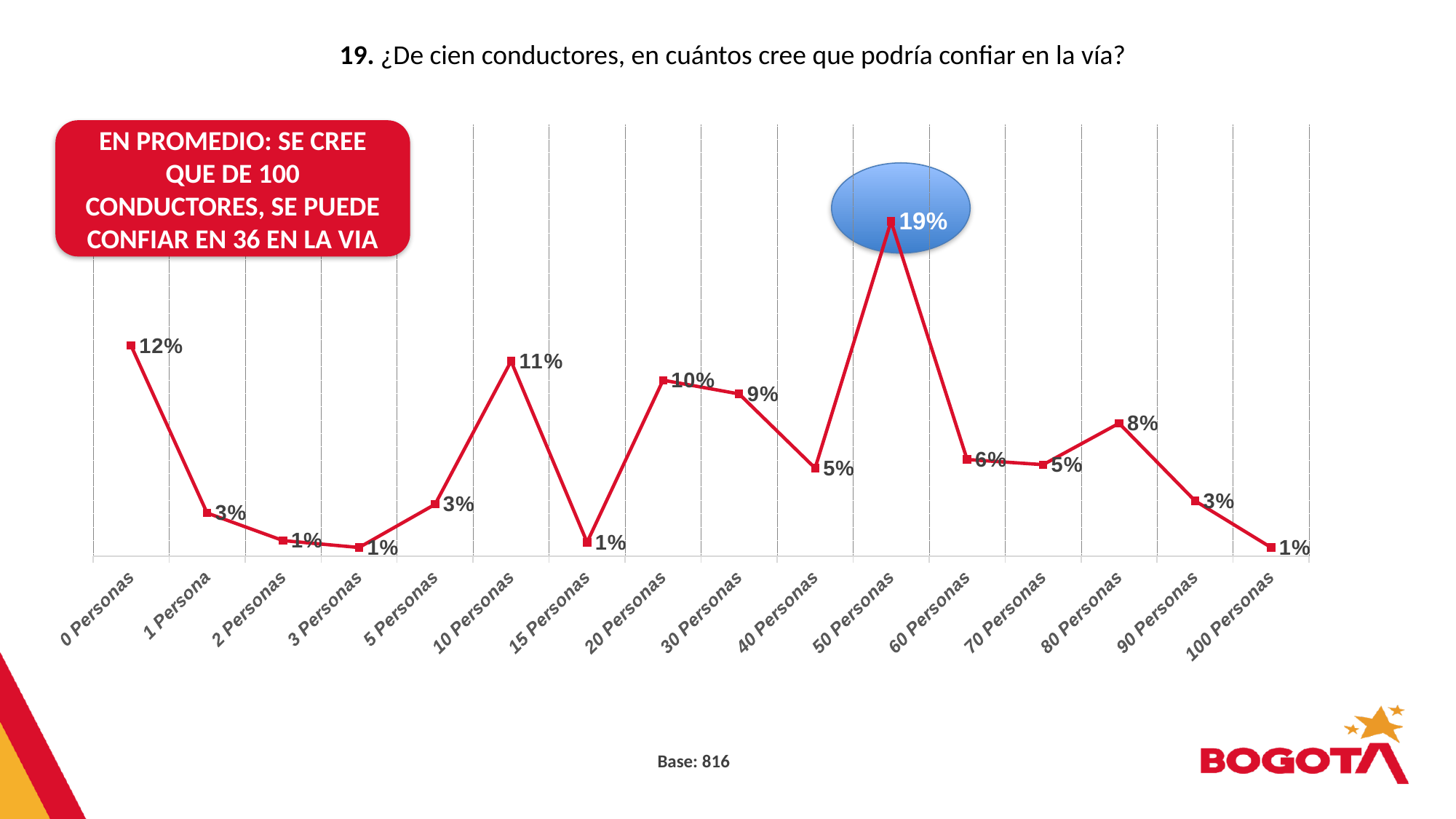
Which category has the highest value? 50 Personas What type of chart is shown on the slide? line chart What is the value for 10 Personas? 11% Do the values rise or fall from 80 Personas to 100 Personas? fall How many categories are plotted on the x axis? 16 What is the base (sample size) stated on the slide? 816 What is the difference between the values for 50 Personas and 0 Personas? 7% What is the difference between the values for 20 Personas and 40 Personas? 5% What is the value for 50 Personas? 19% Which is larger, the value for 30 Personas or the value for 60 Personas? 30 Personas What is the value for 0 Personas? 12% What is the value for 80 Personas? 8%